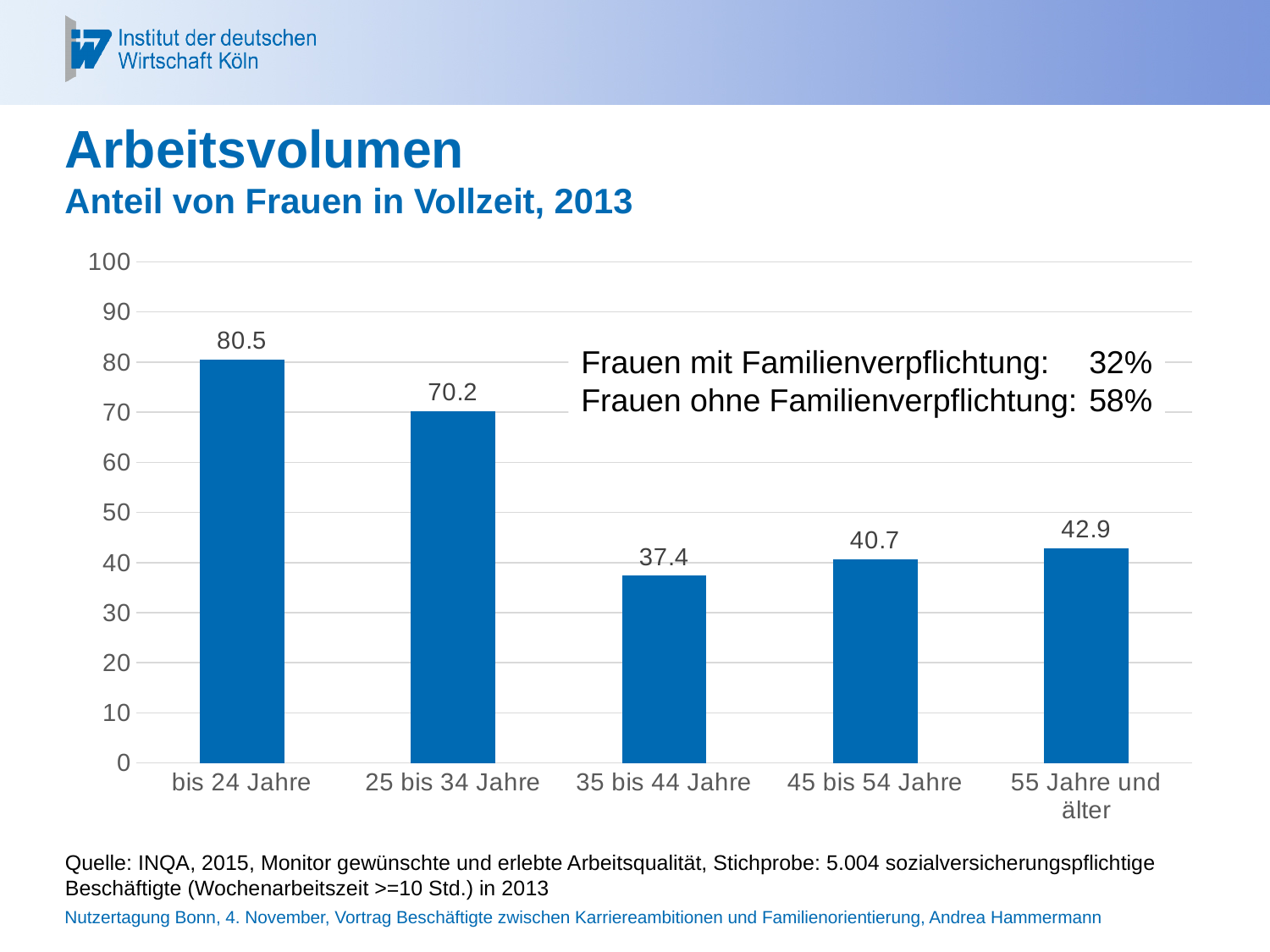
Which age group has the highest value? bis 24 Jahre What kind of chart is shown on the slide? bar chart Which age group has the lowest value? 35 bis 44 Jahre What is the value for the 'bis 24 Jahre' category? 80.5 What is the difference between the values for '55 Jahre und älter' and '45 bis 54 Jahre'? 2.2 According to the text on the chart, what is the share for 'Frauen ohne Familienverpflichtung'? 58% Which is larger, the value for '25 bis 34 Jahre' or the value for '45 bis 54 Jahre'? 25 bis 34 Jahre Is the value for '45 bis 54 Jahre' greater or less than 50? less How many age categories are shown in the chart? 5 What is the value for the '35 bis 44 Jahre' category? 37.4 What is the difference between the values for 'bis 24 Jahre' and '25 bis 34 Jahre'? 10.3 What is the value for the '55 Jahre und älter' category? 42.9